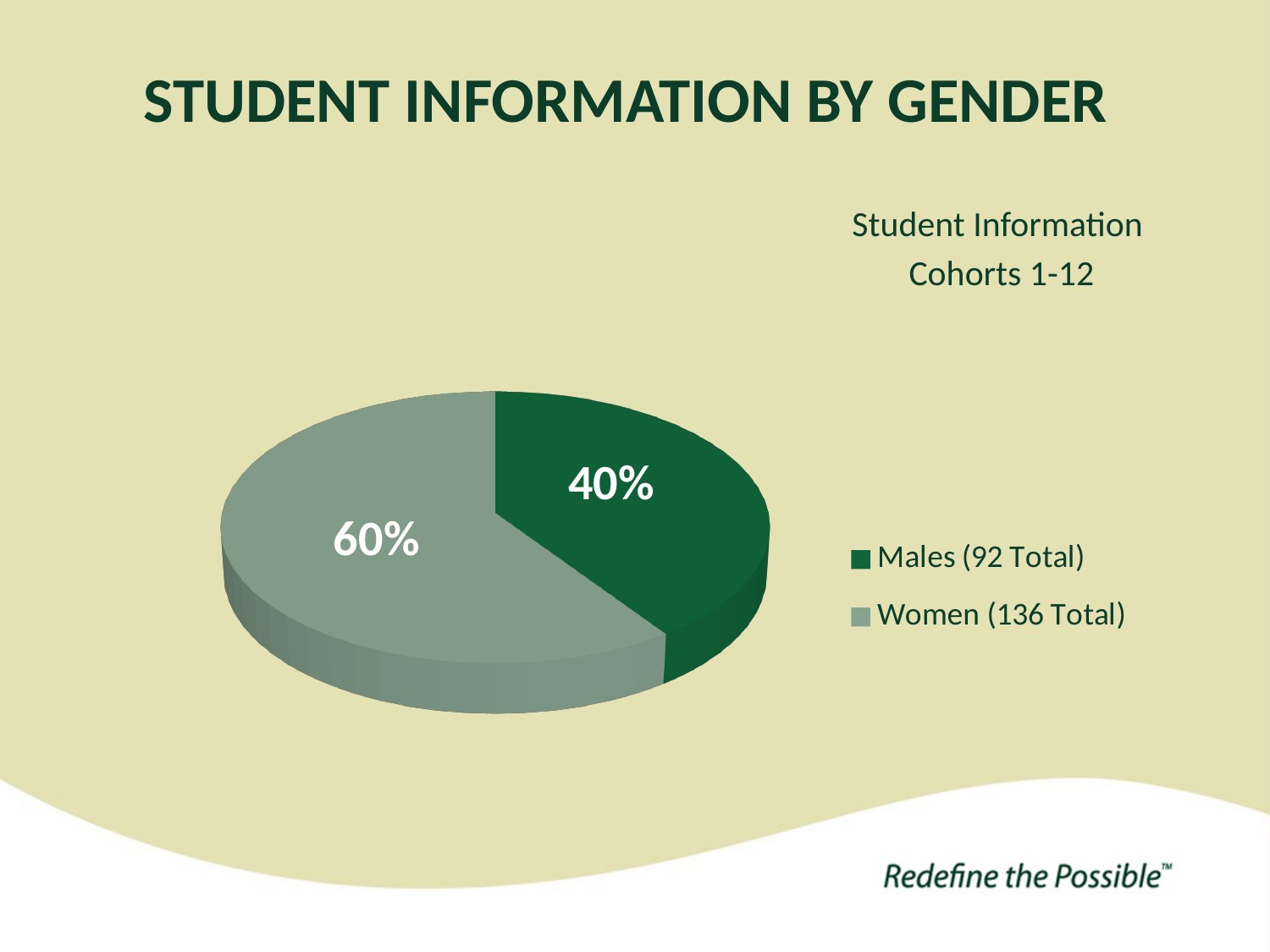
Which slice is the smallest? Males (92 Total) Which slice is the largest? Women (136 Total) What percentage of the pie is the Women slice? 60% What is the difference in percentage points between the Women slice and the Males slice? 20% According to the legend, how many women are there in total? 136 According to the legend, how many males are there in total? 92 What percentage of the pie is the Males slice? 40% What kind of chart is shown on the slide? pie chart How many entries does the legend list? 2 What is the chart's title? Student Information Cohorts 1-12 How many slices does the pie chart have? 2 Which is larger, the Males slice or the Women slice? Women